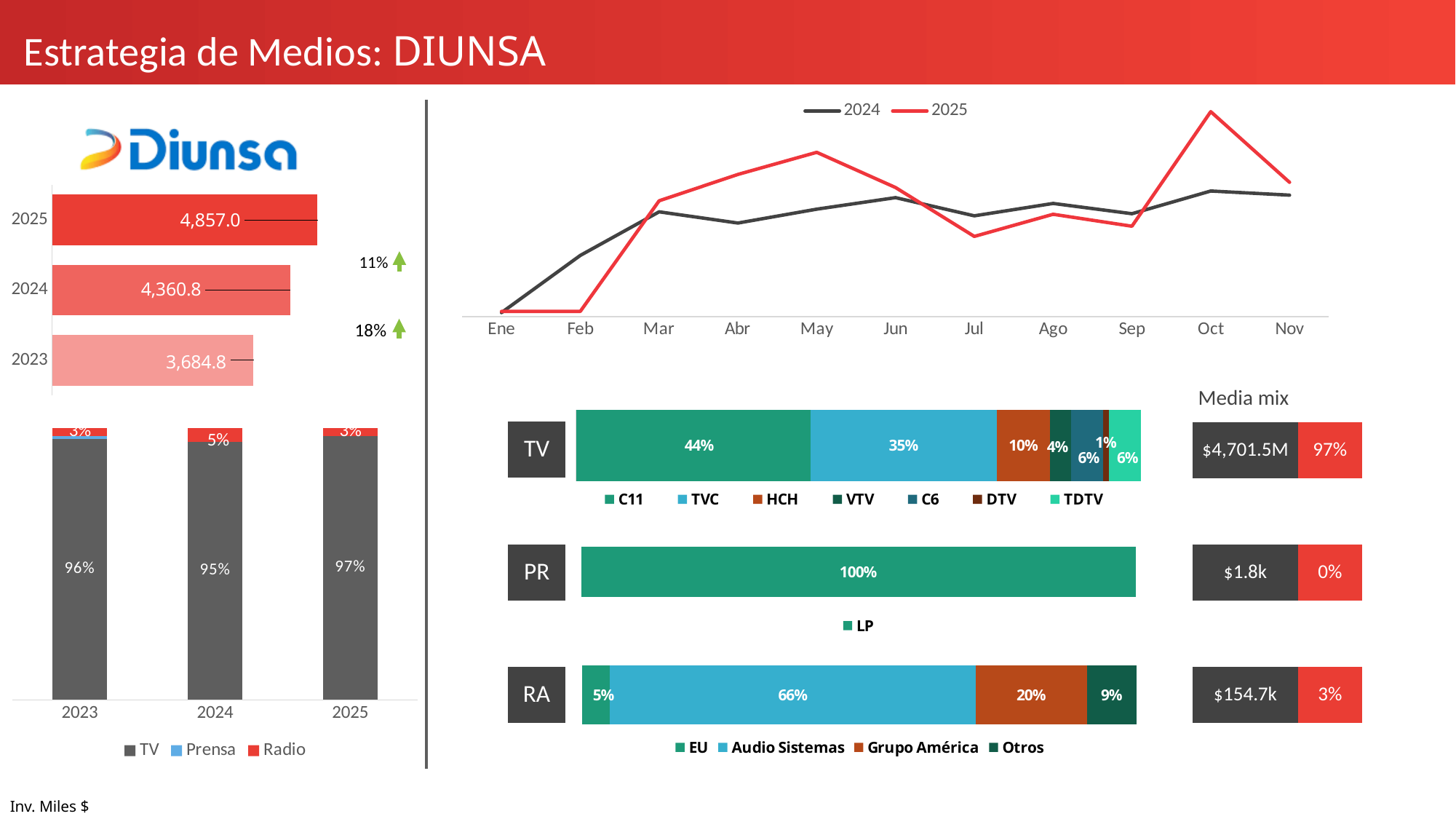
In the horizontal bar chart of yearly investment on the left, which year has the highest value? 2025 In the horizontal bar chart of yearly investment on the left, what is the value for 2025? 4,857.0 In the horizontal bar chart of yearly investment on the left, what is the difference between the 2025 and 2024 values? 496.2 In the stacked bar chart at the bottom left, what is the TV share for 2024? 95% In the monthly line chart at the top right, which series is higher in Oct, 2024 or 2025? 2025 In the horizontal bar chart of yearly investment on the left, what is the value for 2023? 3,684.8 In the TV channel mix bar, what share does C11 have? 44% In the stacked bar chart at the bottom left, how many series does the legend list? 3 In the monthly line chart at the top right, how many series does the legend list? 2 In the monthly line chart at the top right, how many months are shown on the x axis? 11 What kind of chart is the monthly 2024 vs 2025 chart at the top right? line chart In the RA channel mix bar, what share does Audio Sistemas have? 66%